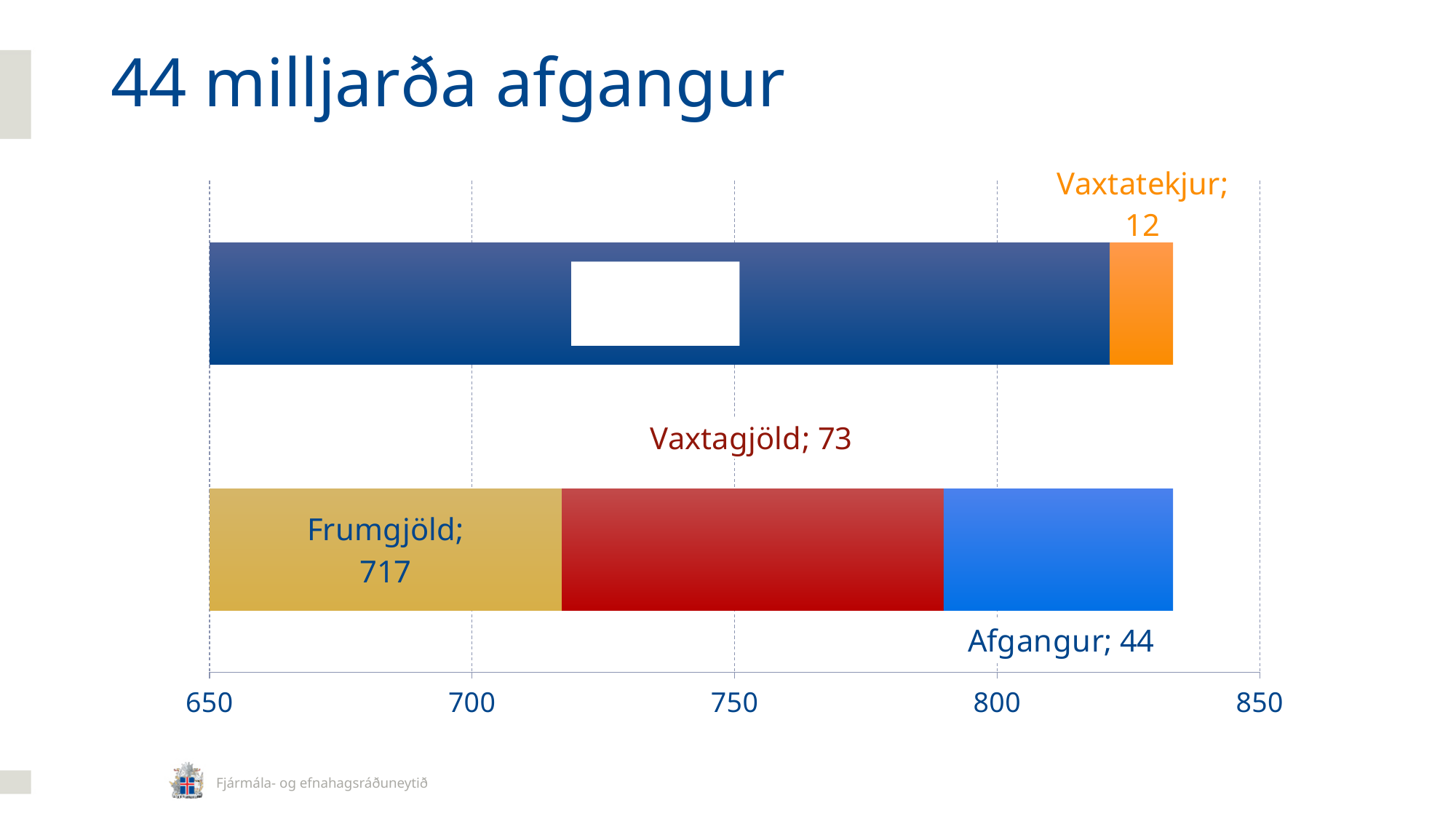
Which labeled segment has the smallest value? Vaxtatekjur What is the difference between Vaxtagjöld and Afgangur? 29 Is the right end of the dark blue segment in the top bar greater or less than 800? greater What is the title of the slide? 44 milljarða afgangur What is the value of Vaxtatekjur in the top bar? 12 What is the value of Frumgjöld in the bottom bar? 717 Which labeled segment has the largest value? Frumgjöld Which is larger, Vaxtagjöld or Afgangur? Vaxtagjöld What kind of chart is shown on the slide? bar chart What is the total of the bottom stacked bar (Frumgjöld, Vaxtagjöld and Afgangur)? 834 What is the value of Afgangur? 44 What is the value of Vaxtagjöld? 73